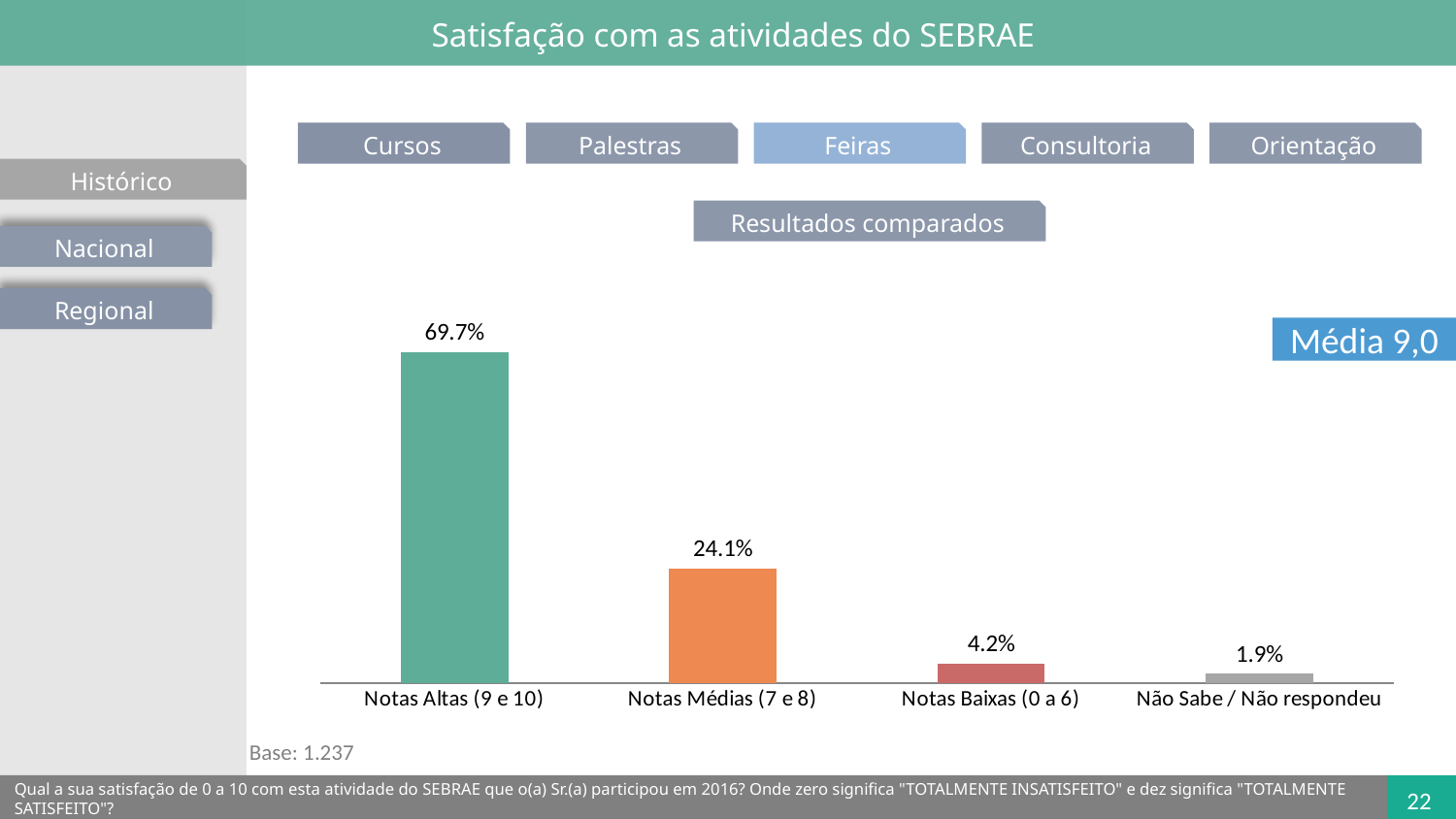
Which category has the highest value? Notas Altas (9 e 10) What is the value for Notas Altas (9 e 10)? 69.7% What is the difference between the values for Notas Altas (9 e 10) and Notas Médias (7 e 8)? 45.6% What is the value for Notas Baixas (0 a 6)? 4.2% What average (Média) is shown in the box next to the chart? 9,0 What kind of chart is shown on the slide? bar chart What is the value for Notas Médias (7 e 8)? 24.1% Which is larger, the value for Notas Médias (7 e 8) or the value for Notas Baixas (0 a 6)? Notas Médias (7 e 8) What is the difference between the values for Notas Baixas (0 a 6) and Não Sabe / Não respondeu? 2.3% Which category has the lowest value? Não Sabe / Não respondeu How many categories are shown on the x axis of the chart? 4 What is the value for Não Sabe / Não respondeu? 1.9%